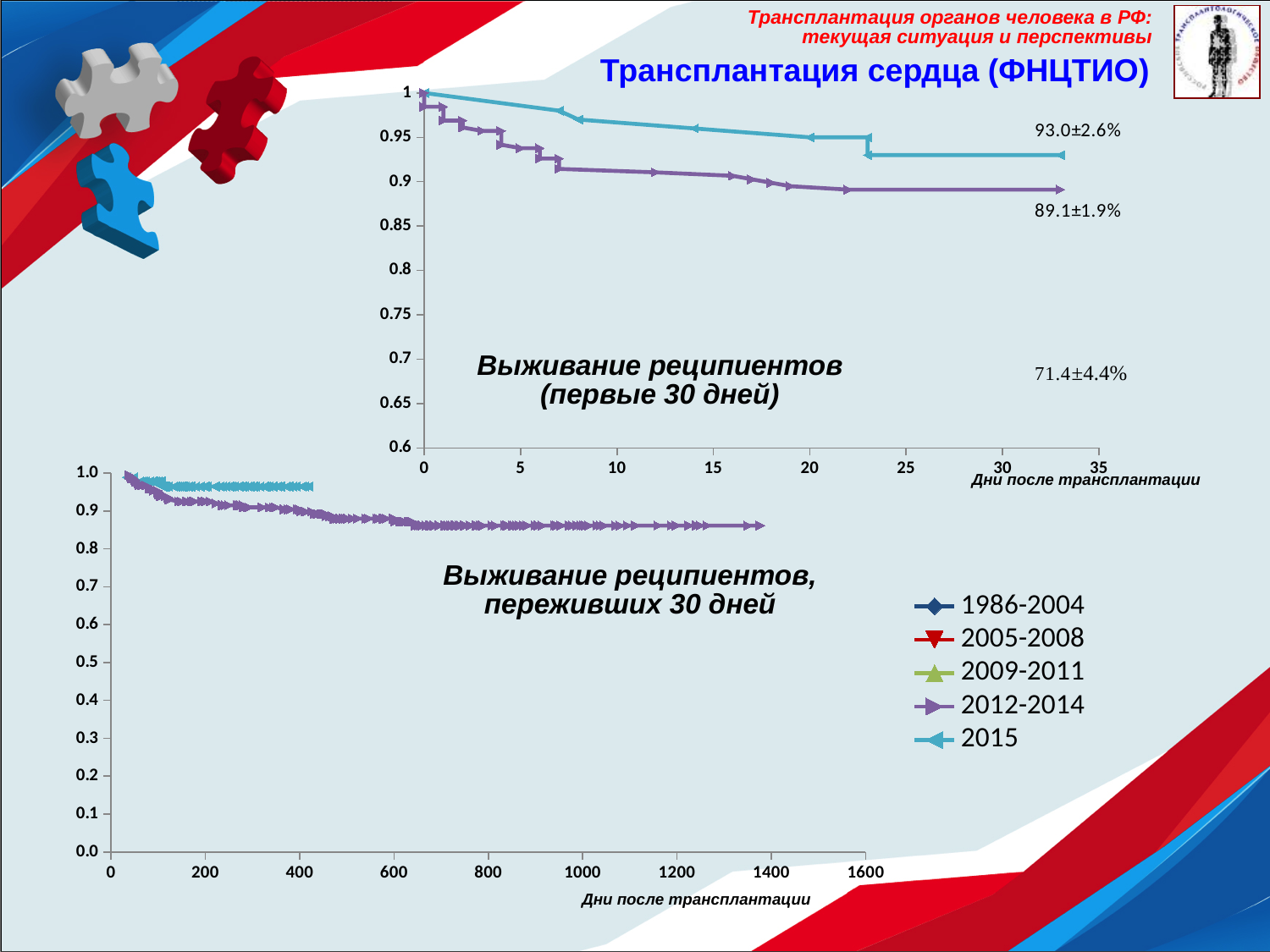
In the top chart (первые 30 дней), do the survival curves rise or fall as days after transplantation increase? fall In the top chart (первые 30 дней), what value is annotated next to the end of the 2015 line? 93.0±2.6% What kind of chart is the top chart titled "Выживание реципиентов (первые 30 дней)"? line chart What is the x-axis label of the bottom chart (переживших 30 дней)? Дни после трансплантации In the top chart (первые 30 дней), which series is higher at day 30: 2015 or 2012-2014? 2015 In the top chart (первые 30 дней), what value is annotated below the end of the 2012-2014 line? 89.1±1.9% What is the lowest value shown on the y axis of the top chart (первые 30 дней)? 0.6 In the bottom chart (переживших 30 дней), is the value of the 2012-2014 series at day 1200 greater or less than 0.9? less In the top chart (первые 30 дней), is the value of the 2015 series at day 33 greater or less than 0.9? greater In the top chart (первые 30 дней), is the value of the 2012-2014 series at day 33 greater or less than 0.85? greater How many series does the legend on the bottom chart list? 5